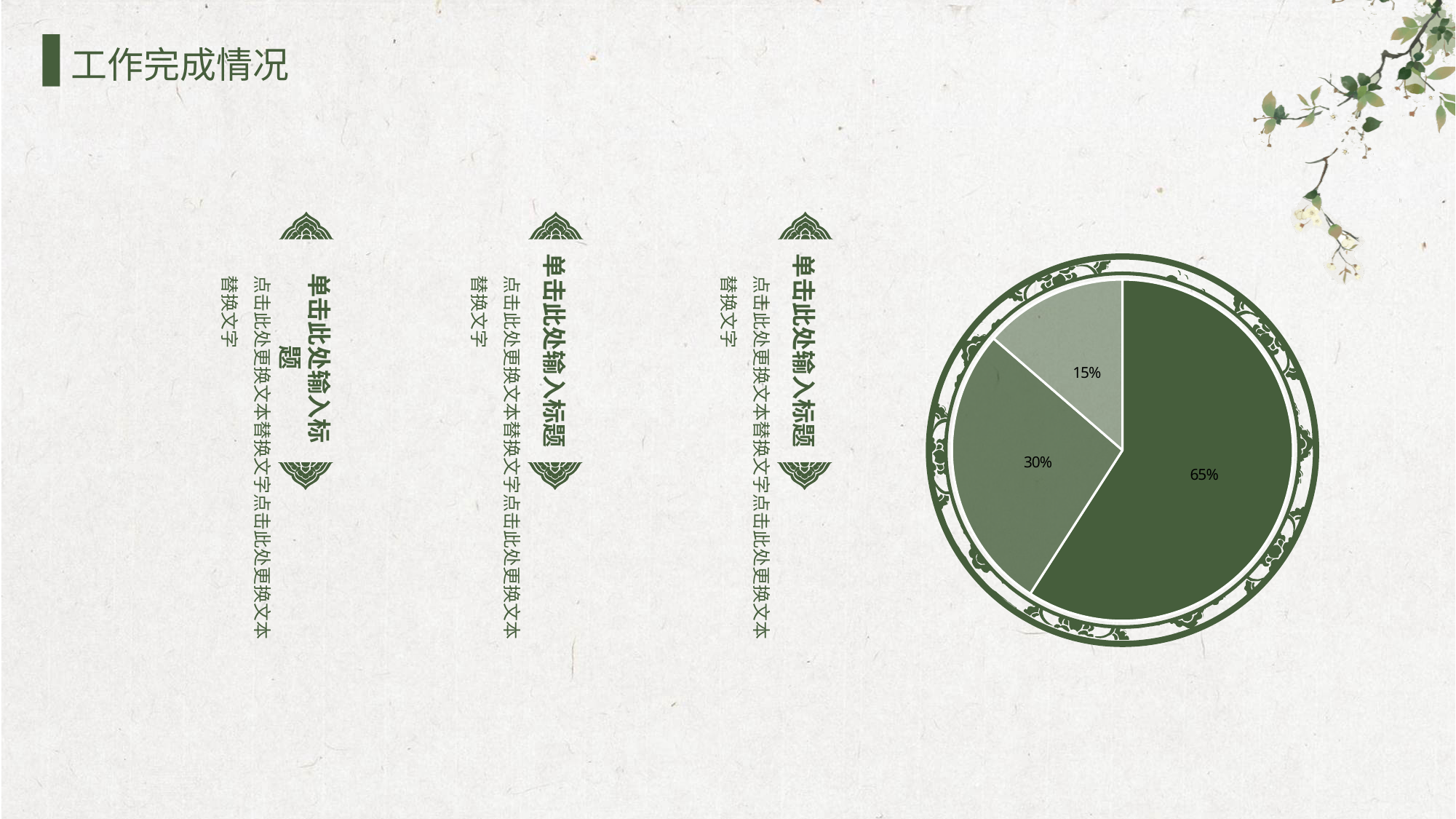
Does the pie chart have a legend? No What percentage is labelled on the medium green slice of the pie chart? 30% How many slices does the pie chart have? 3 What is the difference between the 30% slice and the 15% slice? 15% What percentage is labelled on the darkest green slice of the pie chart? 65% What kind of chart is shown on the slide? pie chart Which slice is larger, the darkest green slice or the medium green slice? the darkest green slice What is the difference between the largest and smallest labelled slices of the pie chart? 50% What is the largest value labelled on the pie chart? 65% What percentage is labelled on the lightest slice of the pie chart? 15% What is the smallest value labelled on the pie chart? 15% Is the value of the largest slice greater or less than 50%? greater